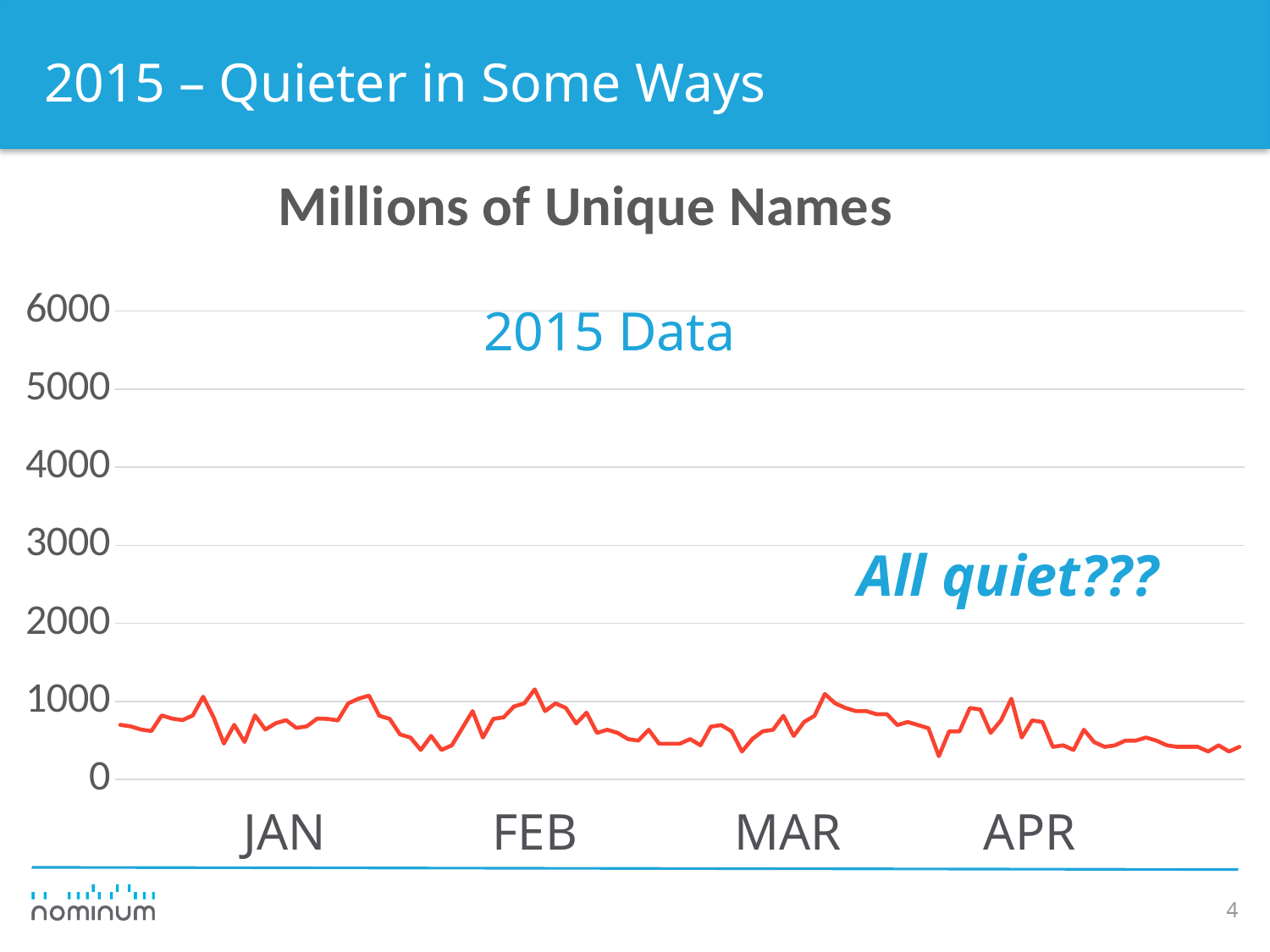
How many lines are plotted on the chart? 1 Does the plotted line ever rise above 2000 on the chart? No How many month labels appear on the x axis of the chart? 4 Is the value at the start of JAN greater or less than 2000? less Does the plotted line ever rise above 3000 on the chart? No What is the lowest value shown on the y axis of the chart? 0 What kind of chart is shown on the slide? line chart Which months are labelled on the x axis of the chart? JAN, FEB, MAR, APR What is the highest value shown on the y axis of the chart? 6000 What is the title of the chart? Millions of Unique Names